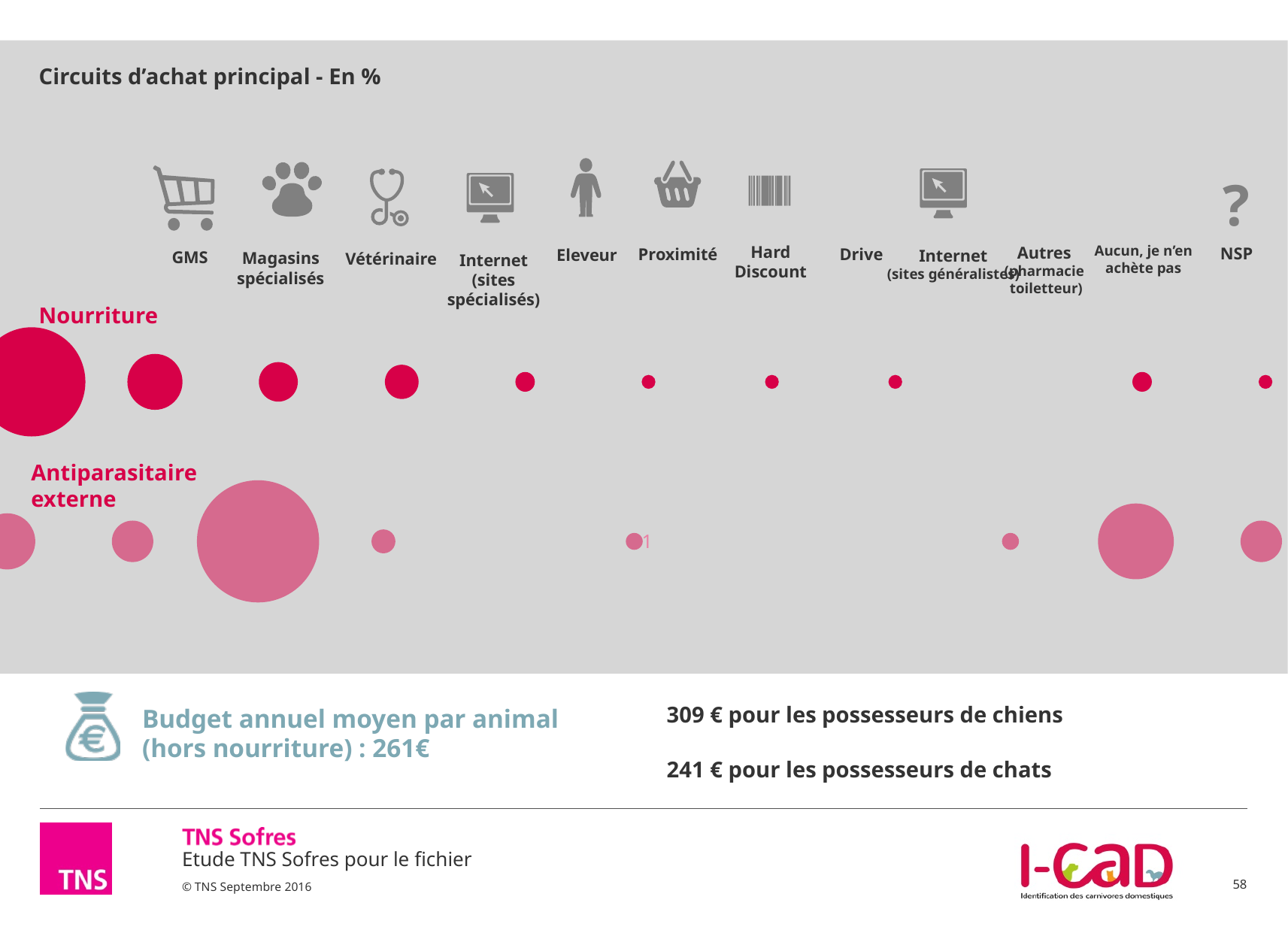
What kind of chart is used on this slide to show the main purchase channels? bubble chart In the Antiparasitaire externe row, which bubble is the largest? the third bubble from the left How many product rows (series) does the bubble chart show? 2 What is the title of the chart? Circuits d'achat principal - En % Is the largest bubble in the Nourriture row larger or smaller than the largest bubble in the Antiparasitaire externe row? smaller How many purchase channel categories are listed across the top of the chart? 12 How many bubbles are plotted in the Antiparasitaire externe row? 8 In the Nourriture row, do the bubble sizes generally increase or decrease from left to right? decrease How many bubbles are plotted in the Nourriture row? 10 What are the names of the two rows in the bubble chart? Nourriture and Antiparasitaire externe In the Nourriture row, which bubble is the largest? the leftmost (first) bubble